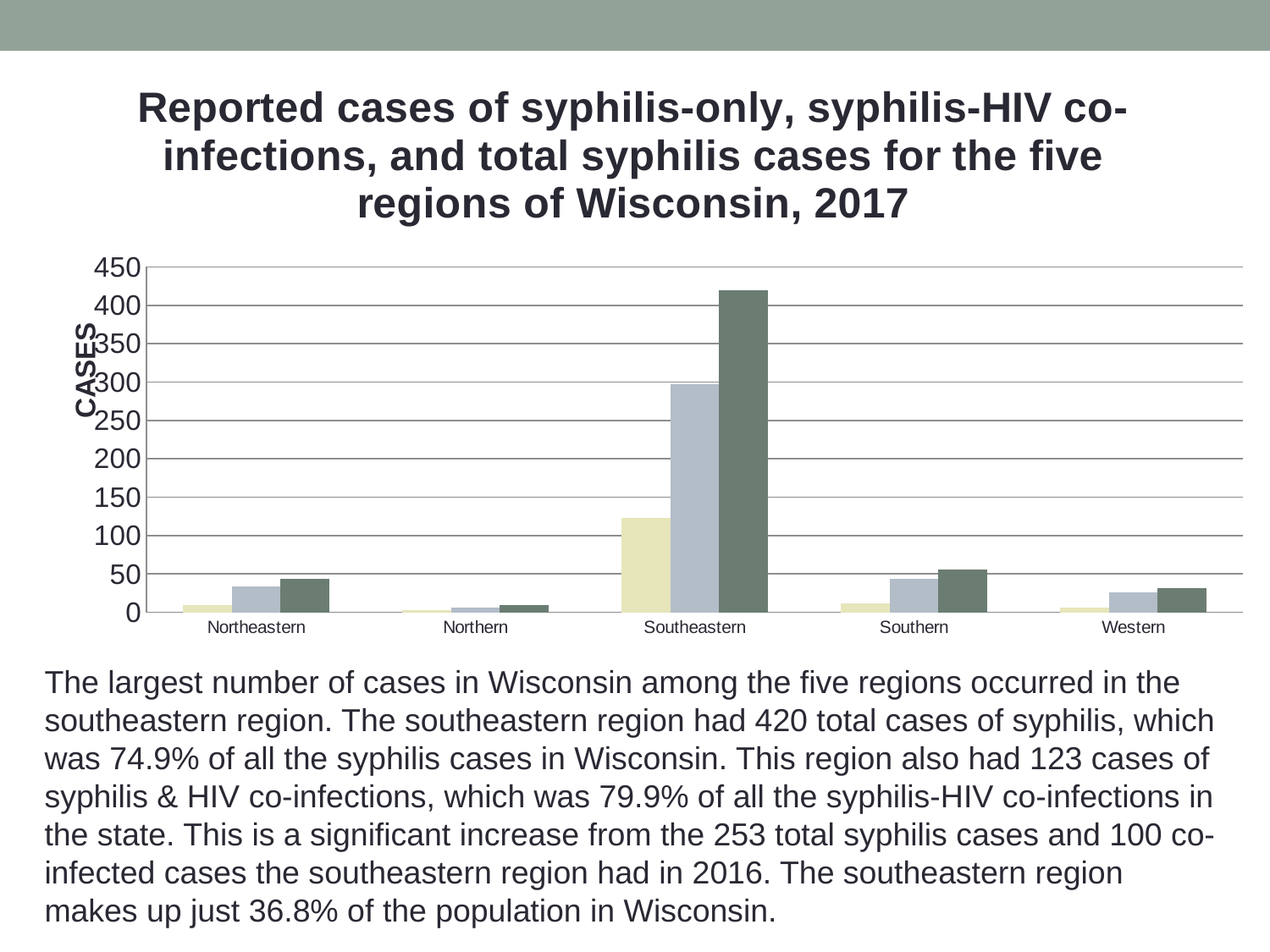
What kind of chart is shown on the slide? bar chart Is the value of the dark green bar for Western greater or less than 50? less How many bars are plotted for each region in the chart? 3 Is the value of the pale yellow bar for Southeastern greater or less than 100? greater Is the value of the dark green bar for Southeastern greater or less than 400? greater Which region has the larger dark green bar, Southern or Western? Southern Which region has the shortest bars in the chart? Northern How many regions are shown on the x axis of the chart? 5 Which region has the tallest bars in the chart? Southeastern What is the label on the y axis of the chart? CASES